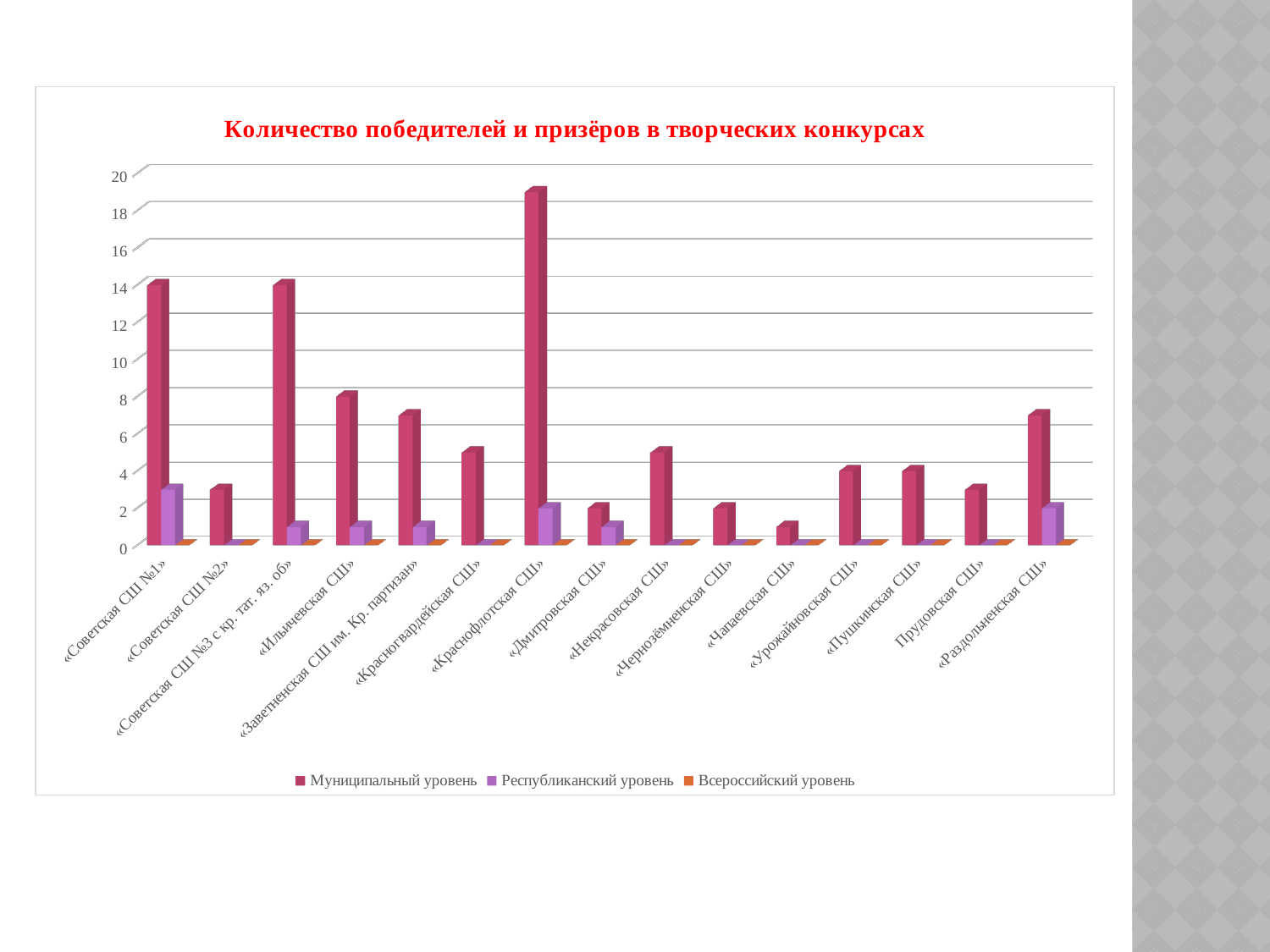
Is the Муниципальный уровень value for «Советская СШ №1» greater or less than 12? greater Is the Муниципальный уровень value for «Ильичевская СШ» greater or less than 6? greater What kind of chart is shown on the slide? bar chart Is the Муниципальный уровень value for «Чапаевская СШ» greater or less than 2? less Which school has the highest value for Муниципальный уровень? «Краснофлотская СШ» Which school has the lowest value for Муниципальный уровень? «Чапаевская СШ» How many series does the legend list? 3 How many schools (categories) are shown on the x axis? 15 Which has the larger Муниципальный уровень value, «Советская СШ №1» or «Советская СШ №2»? «Советская СШ №1» What is the title of the chart? Количество победителей и призёров в творческих конкурсах Which series is shown in orange in the legend? Всероссийский уровень